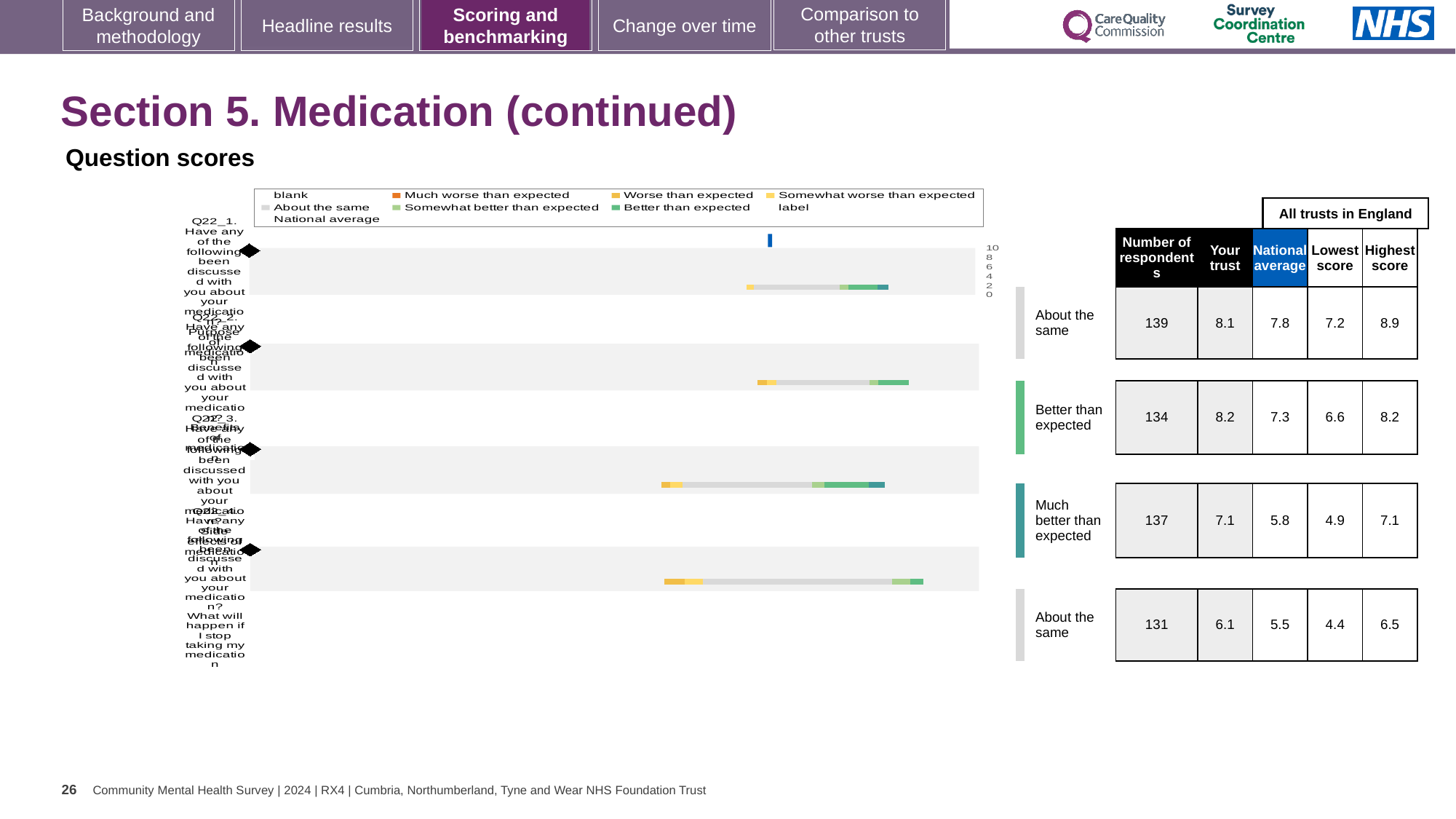
Which row of the table has the lowest 'Your trust' score? the fourth row (Q22_4), 6.1 What is the lowest score among all trusts in England for the second question (Q22_2)? 6.6 Which row of the table has the highest 'Your trust' score? the second row (Q22_2), 8.2 For the first question (Q22_1), which is larger: the 'Your trust' score or the national average? Your trust (8.1) How many questions (bars) are plotted in the question scores chart? 4 What is the national average for the second question (Q22_2, second row of the table)? 7.3 For the third question (Q22_3), what is the difference between the 'Your trust' score and the national average? 1.3 How many respondents are listed for the third question (Q22_3, third row of the table)? 137 What is the highest score among all trusts in England for the fourth question (Q22_4, bottom row of the table)? 6.5 What kind of chart is used to show the question scores on this slide? bar chart What benchmark label is given to the third question (Q22_3) in the table? Much better than expected What is the 'Your trust' score for the first question (Q22_1, top row of the table)? 8.1